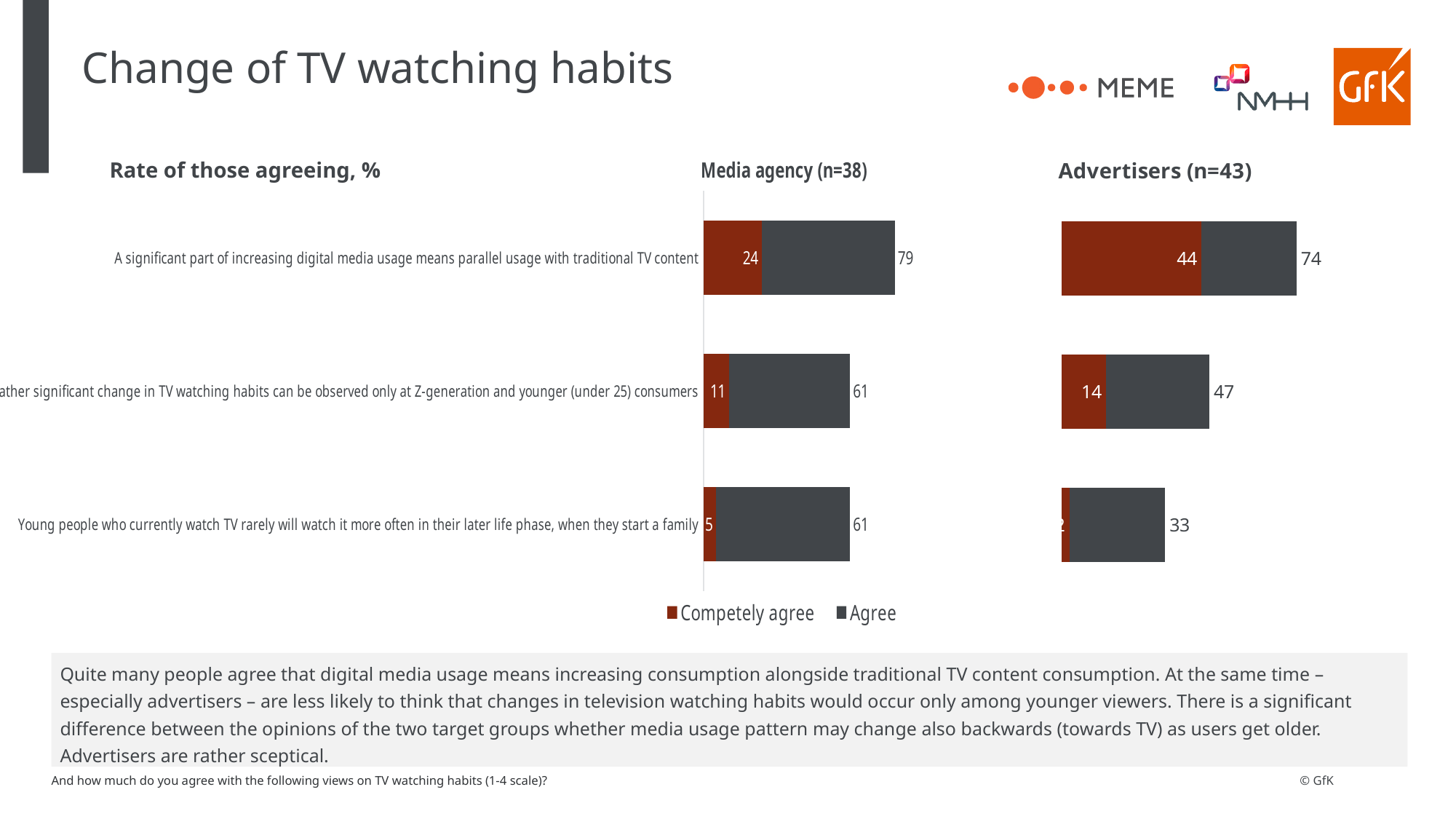
In the Media agency (n=38) chart, what is the total rate of those agreeing with the statement that a significant part of increasing digital media usage means parallel usage with traditional TV content? 79 In the Advertisers (n=43) chart, what is the total rate of those agreeing that young people who currently watch TV rarely will watch it more often when they start a family? 33 In the Advertisers (n=43) chart, which statement has the lowest total rate of agreement? Young people who currently watch TV rarely will watch it more often in their later life phase, when they start a family What kind of chart is used in the Media agency (n=38) chart? Stacked bar chart For the statement about parallel usage with traditional TV content, how much higher is the total agreement rate in the Media agency (n=38) chart than in the Advertisers (n=43) chart? 5 In the Media agency (n=38) chart, what is the difference between the 'Completely agree' values for the parallel usage statement and the Z-generation statement? 13 In the Advertisers (n=43) chart, what is the total rate of those agreeing with the statement about change being observed only at Z-generation and younger (under 25) consumers? 47 In the Media agency (n=38) chart, what is the 'Completely agree' value for the statement that significant change in TV watching habits can be observed only at Z-generation and younger (under 25) consumers? 11 For the Z-generation statement, which group has the higher total agreement rate: Media agency (n=38) or Advertisers (n=43)? Media agency (n=38) In the Media agency (n=38) chart, which statement has the highest total rate of agreement? A significant part of increasing digital media usage means parallel usage with traditional TV content How many series does the legend list for the charts on this slide? 2 In the Advertisers (n=43) chart, what is the 'Completely agree' value for the statement about parallel usage with traditional TV content? 44